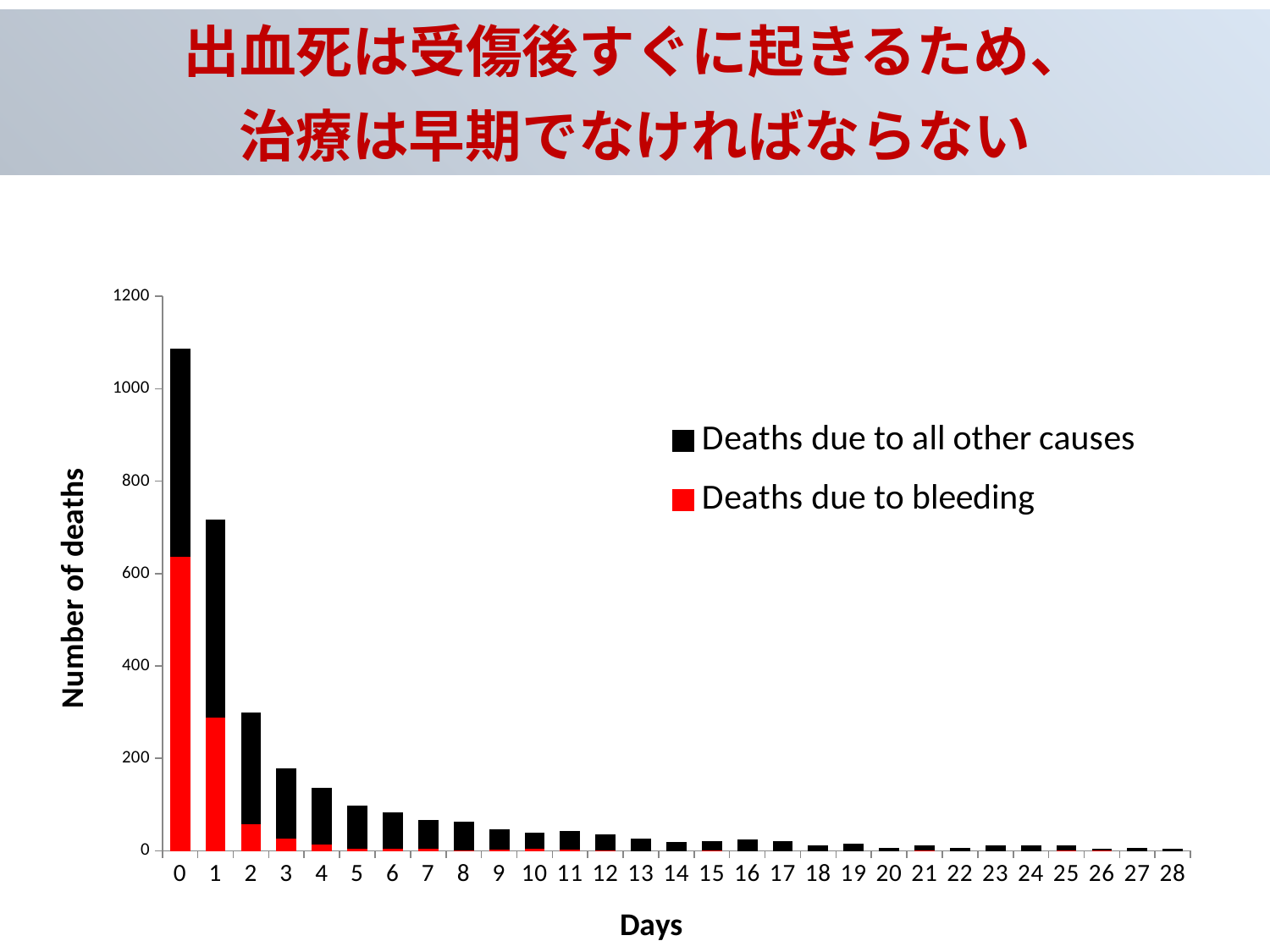
Do the total deaths rise or fall as the days increase along the x axis? Fall Which has more total deaths, day 0 or day 1? Day 0 Which day has the highest total number of deaths? 0 Is the total number of deaths on day 2 greater or less than 200? greater Is the total number of deaths on day 1 greater or less than 800? less What is the title of the y axis? Number of deaths Is the total number of deaths on day 0 greater or less than 1000? greater Which colour represents deaths due to bleeding in the legend? Red How many day categories are shown on the x axis? 29 What kind of chart is shown on the slide? Stacked bar chart How many series does the legend list? 2